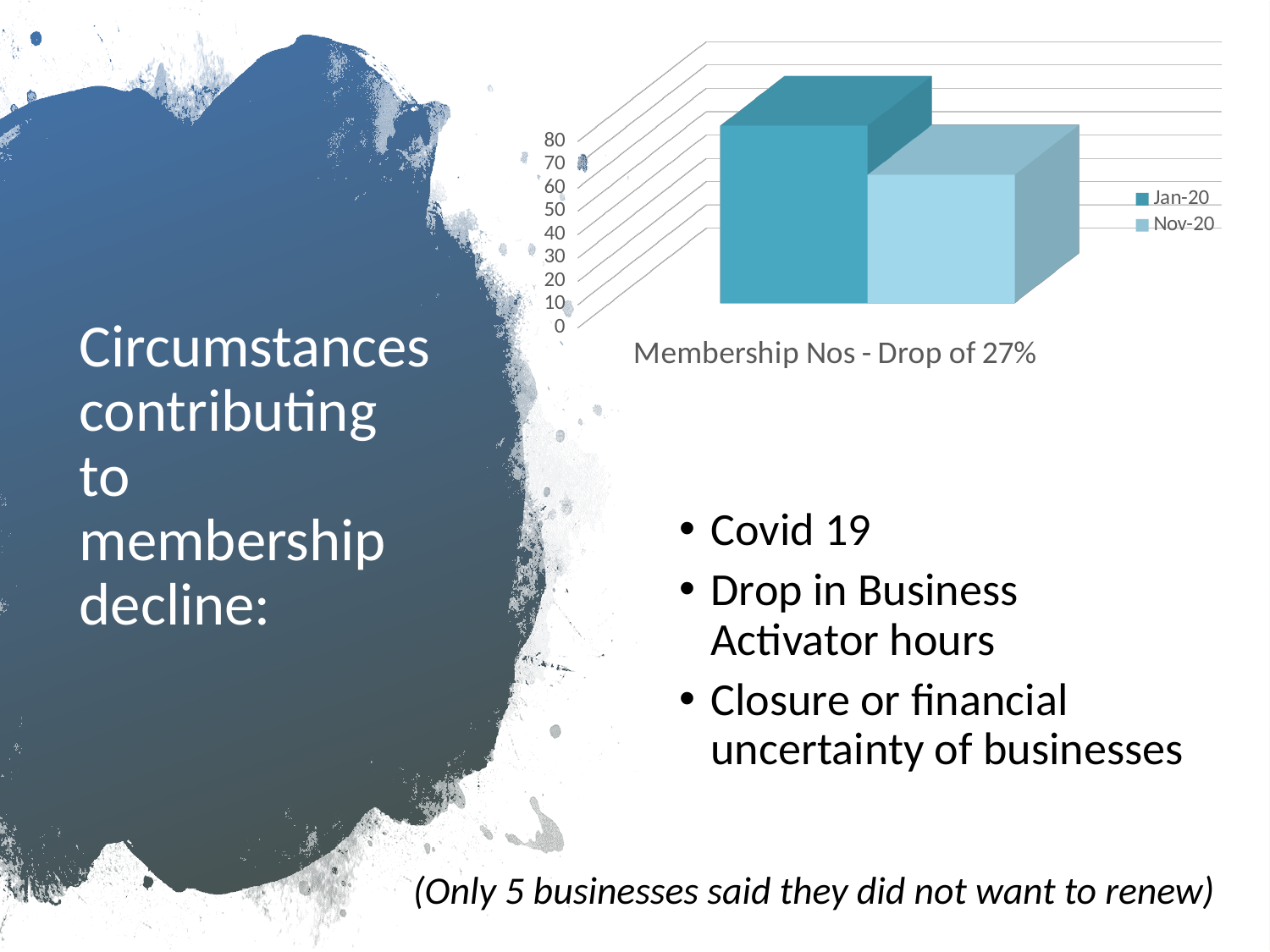
Is the value for Nov-20 greater or less than 80? less Do membership numbers rise or fall from Jan-20 to Nov-20? fall How many series does the chart legend list? 2 How many bars are plotted in the chart? 2 Which series has the taller bar, Jan-20 or Nov-20? Jan-20 What is the title of the chart? Membership Nos - Drop of 27% Is the value for Jan-20 greater or less than 40? greater Which series has the highest value in the chart? Jan-20 What kind of chart is shown on the slide? bar chart Which series has the lowest value in the chart? Nov-20 What is the highest value shown on the chart's vertical axis? 80 Is the value for Nov-20 greater or less than 30? greater